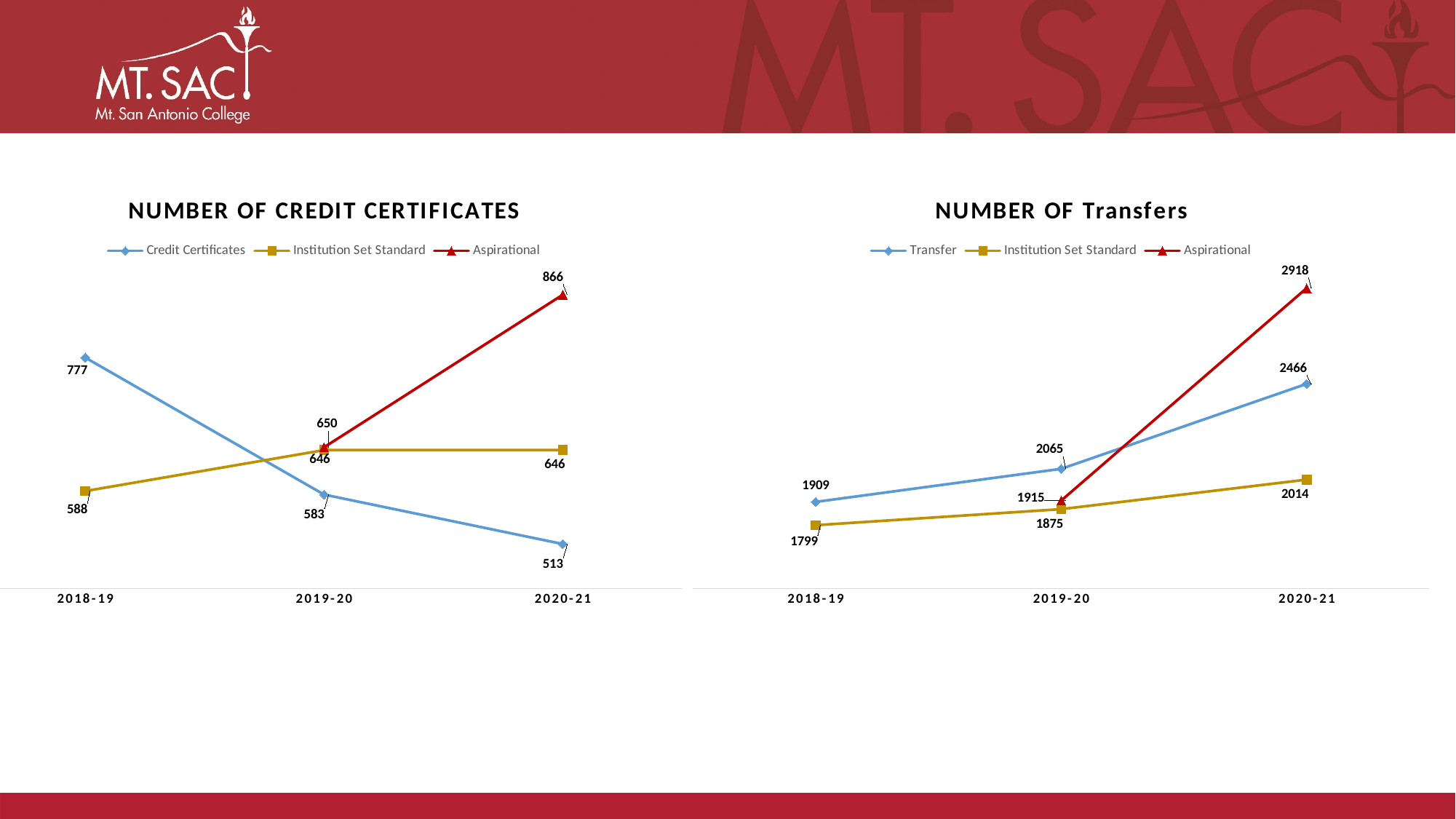
In the NUMBER OF Transfers chart, which is larger in 2020-21: the Aspirational value or the Transfer value? Aspirational In the NUMBER OF CREDIT CERTIFICATES chart, what is the difference between the Aspirational value and the Institution Set Standard value in 2020-21? 220 How many years are shown on the x axis of the NUMBER OF Transfers chart? 3 In the NUMBER OF CREDIT CERTIFICATES chart, in which year is the Credit Certificates value lowest? 2020-21 In the NUMBER OF Transfers chart, what is the Transfer value for 2020-21? 2466 In the NUMBER OF Transfers chart, what is the difference between the Transfer values for 2020-21 and 2018-19? 557 In the NUMBER OF Transfers chart, what is the Institution Set Standard value for 2018-19? 1799 In the NUMBER OF CREDIT CERTIFICATES chart, what is the value for Credit Certificates in 2018-19? 777 In the NUMBER OF CREDIT CERTIFICATES chart, does the Credit Certificates series rise or fall from 2018-19 to 2020-21? fall What type of chart is the NUMBER OF Transfers chart? line chart How many series does the legend of the NUMBER OF CREDIT CERTIFICATES chart list? 3 In the NUMBER OF CREDIT CERTIFICATES chart, what is the Aspirational value for 2020-21? 866